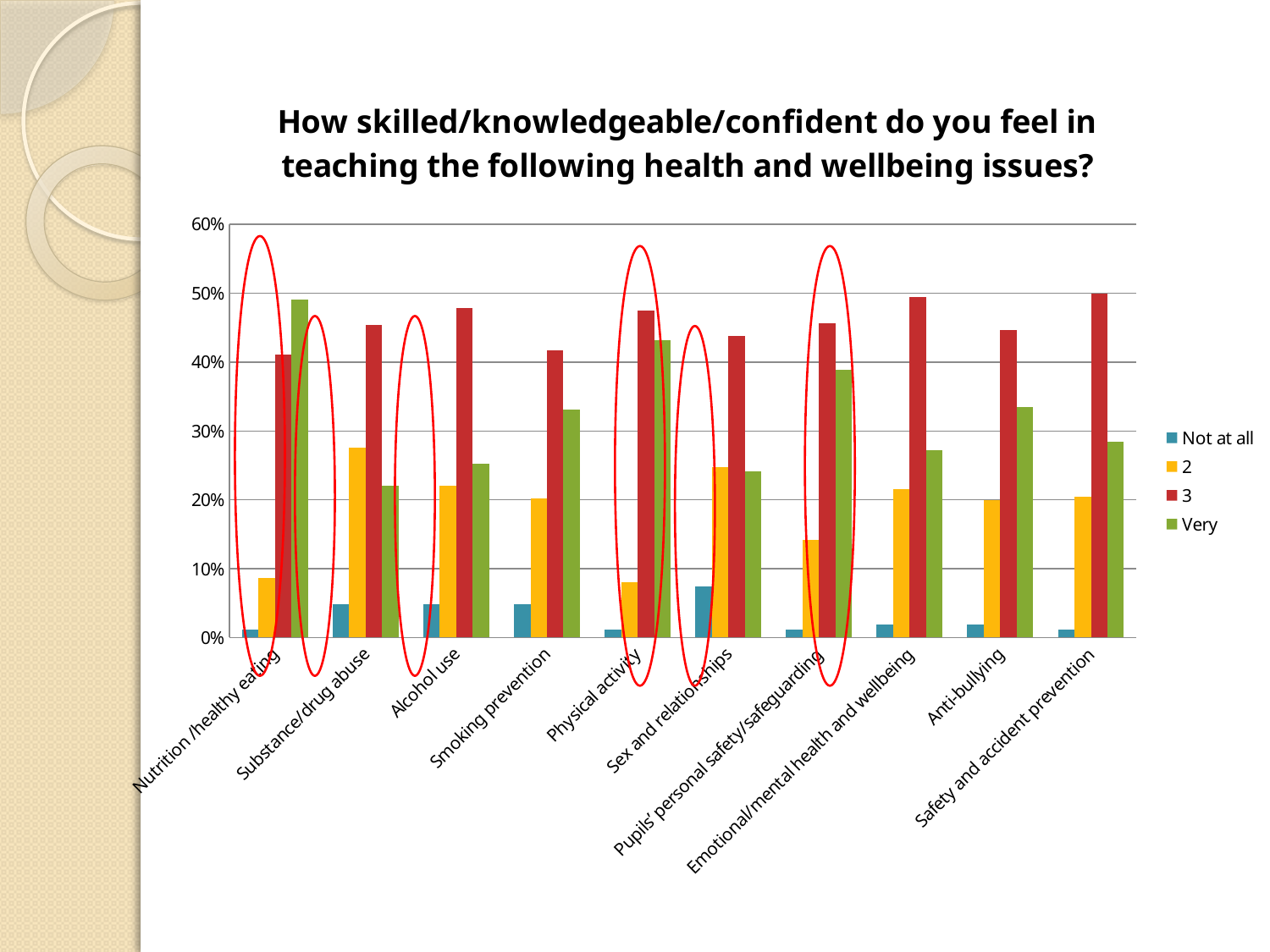
Is the '2' value for Substance/drug abuse greater or less than 20%? greater Is the '2' value for Pupils' personal safety/safeguarding greater or less than 20%? less What kind of chart is shown on the slide? bar chart Is the 'Very' value for Nutrition /healthy eating greater or less than 40%? greater How many series does the legend list? 4 For Nutrition /healthy eating, which is larger: the '3' value or the 'Very' value? Very Which legend entry is shown in red? 3 Which category has the highest 'Not at all' value? Sex and relationships For Substance/drug abuse, which is larger: the '2' value or the 'Very' value? 2 Which category has the highest 'Very' value? Nutrition /healthy eating How many health and wellbeing issues (categories) are shown on the x axis? 10